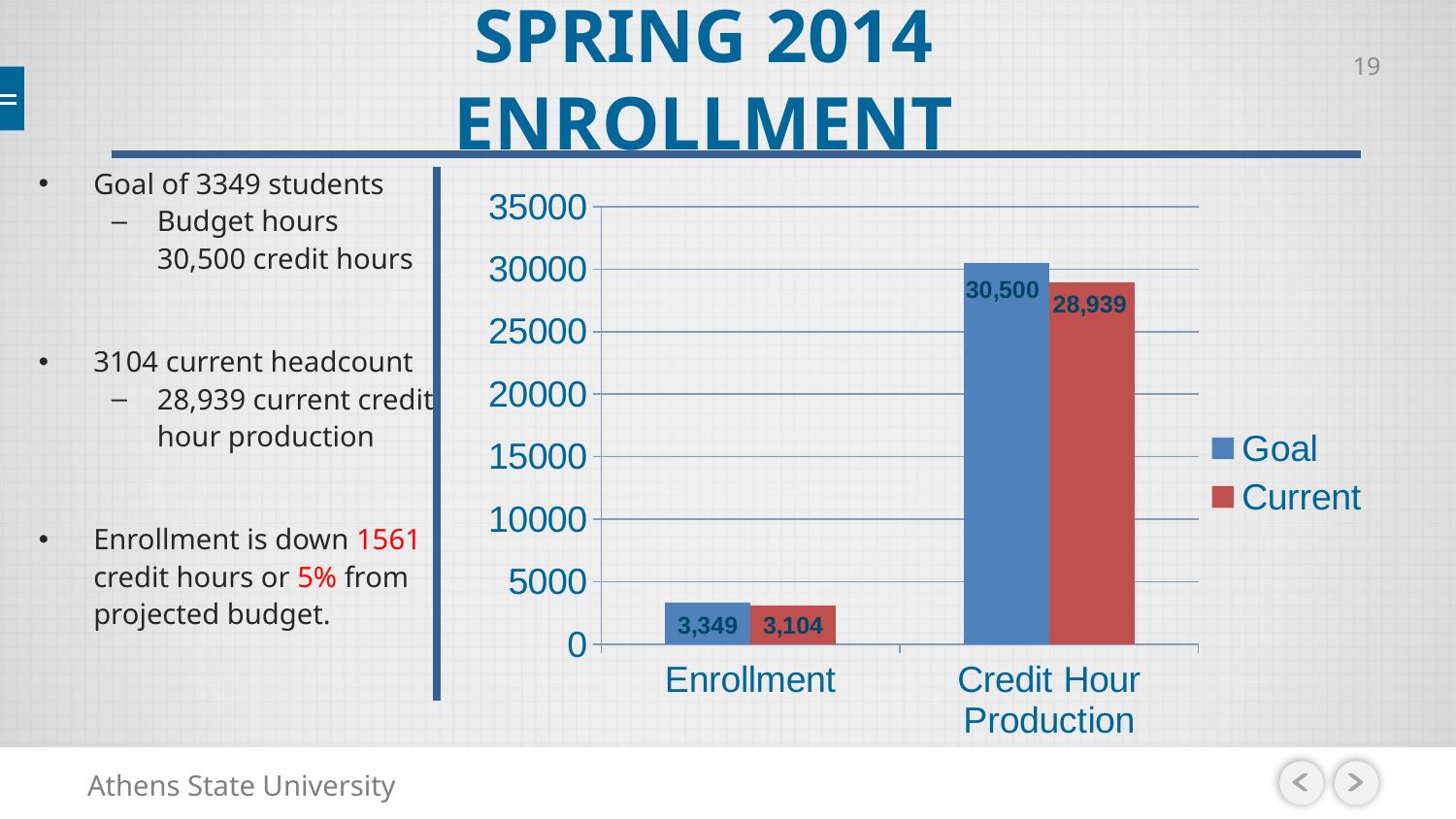
Which category has the highest Goal value? Credit Hour Production What is the Goal value for Credit Hour Production? 30,500 What is the Goal value for Enrollment? 3,349 How many categories are shown on the x axis? 2 Which category has the lowest Current value? Enrollment What is the difference between the Goal and Current values for Enrollment? 245 What is the Current value for Enrollment? 3,104 What is the difference between the Goal and Current values for Credit Hour Production? 1,561 What is the Current value for Credit Hour Production? 28,939 For Credit Hour Production, which is larger, the Goal or the Current value? Goal What kind of chart is shown on the slide? Bar chart How many series does the legend list? 2